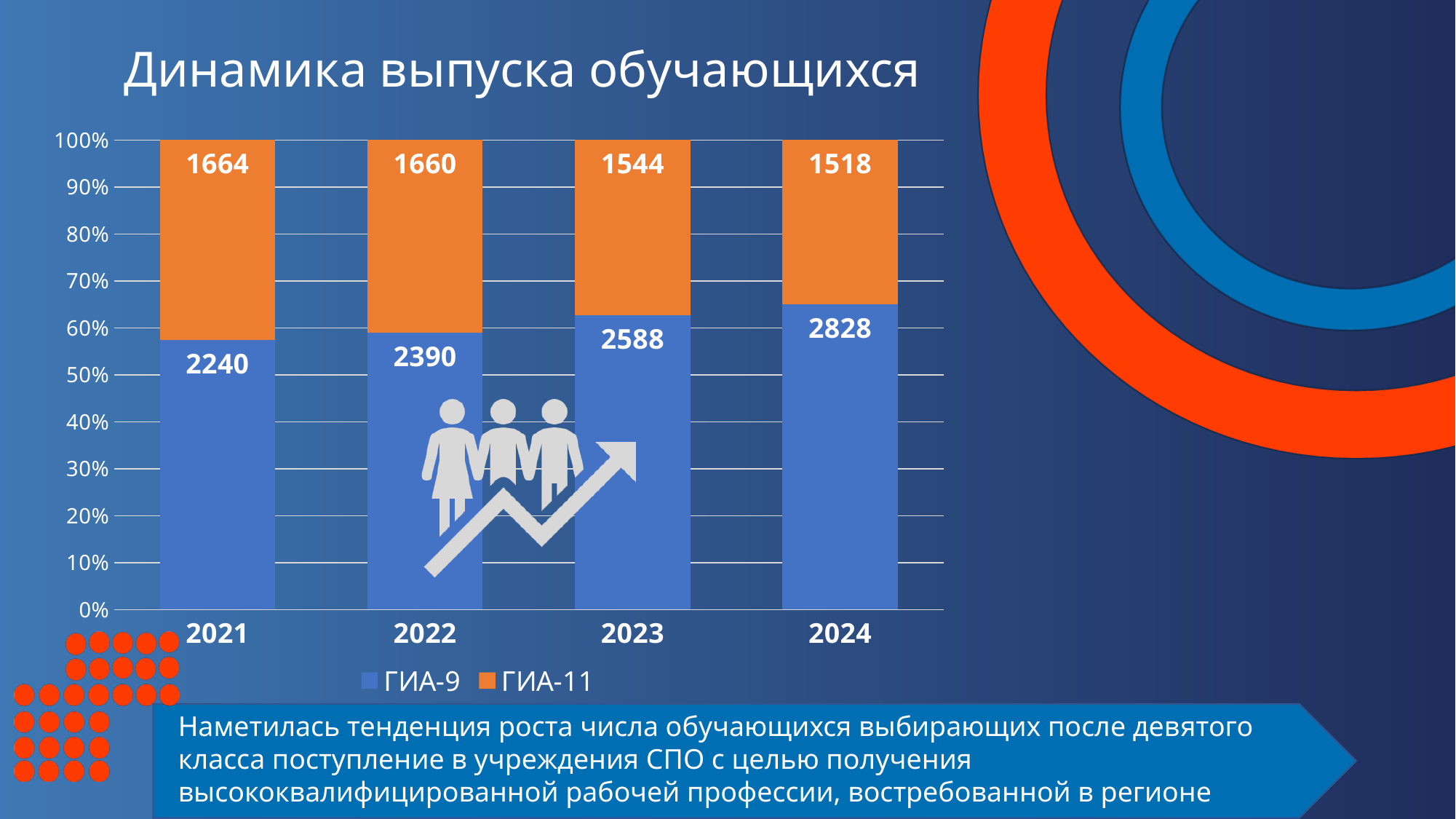
Do the ГИА-11 values rise or fall from 2021 to 2024? Fall In which year is the ГИА-9 value highest? 2024 What is the value for ГИА-9 in 2022? 2390 Which is larger in 2023: the ГИА-9 value or the ГИА-11 value? ГИА-9 What is the value for ГИА-9 in 2024? 2828 How many years are shown on the x axis? 4 What is the total of the ГИА-9 and ГИА-11 values for 2023? 4132 How many series does the legend list? 2 What is the difference between the ГИА-9 values for 2024 and 2021? 588 What kind of chart is shown on the slide? Stacked bar chart In which year is the ГИА-11 value lowest? 2024 What is the value for ГИА-11 in 2021? 1664